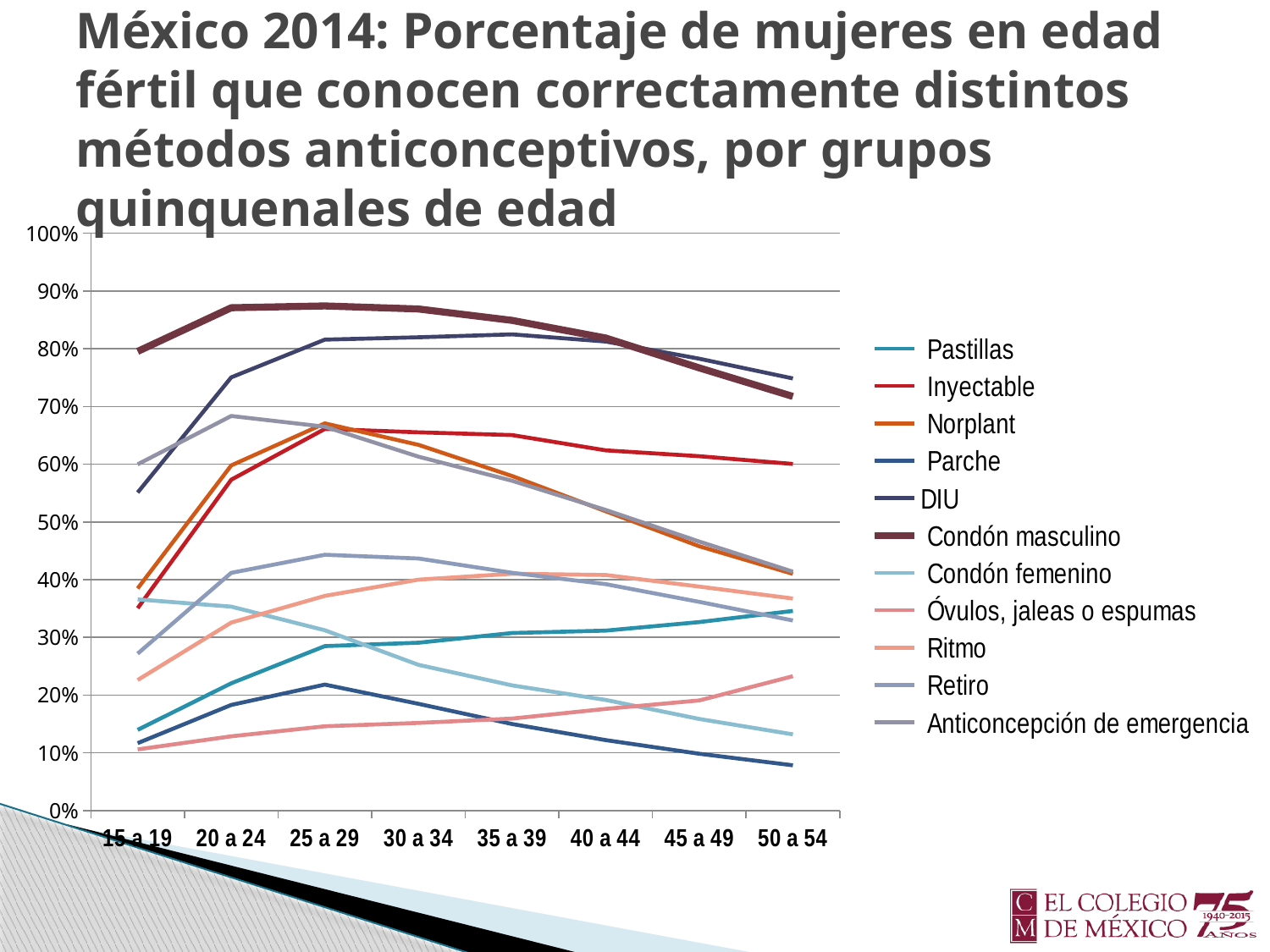
What kind of chart is shown on the slide? line chart Is the value for Condón masculino in the 20 a 24 age group greater or less than 80%? greater How many series does the legend list? 11 In the 15 a 19 age group, which is larger: Anticoncepción de emergencia or Retiro? Anticoncepción de emergencia Which series has the lowest value for the 50 a 54 age group? Parche Does the value for Óvulos, jaleas o espumas rise or fall from the 15 a 19 age group to the 50 a 54 age group? rise Is the value for Condón femenino in the 50 a 54 age group greater or less than 20%? less Which series has the highest value for the 25 a 29 age group? Condón masculino Does the value for Parche rise or fall from the 25 a 29 age group to the 50 a 54 age group? fall What is the first entry listed in the legend? Pastillas Is the value for Parche in the 50 a 54 age group greater or less than 10%? less How many age groups are shown on the x axis? 8